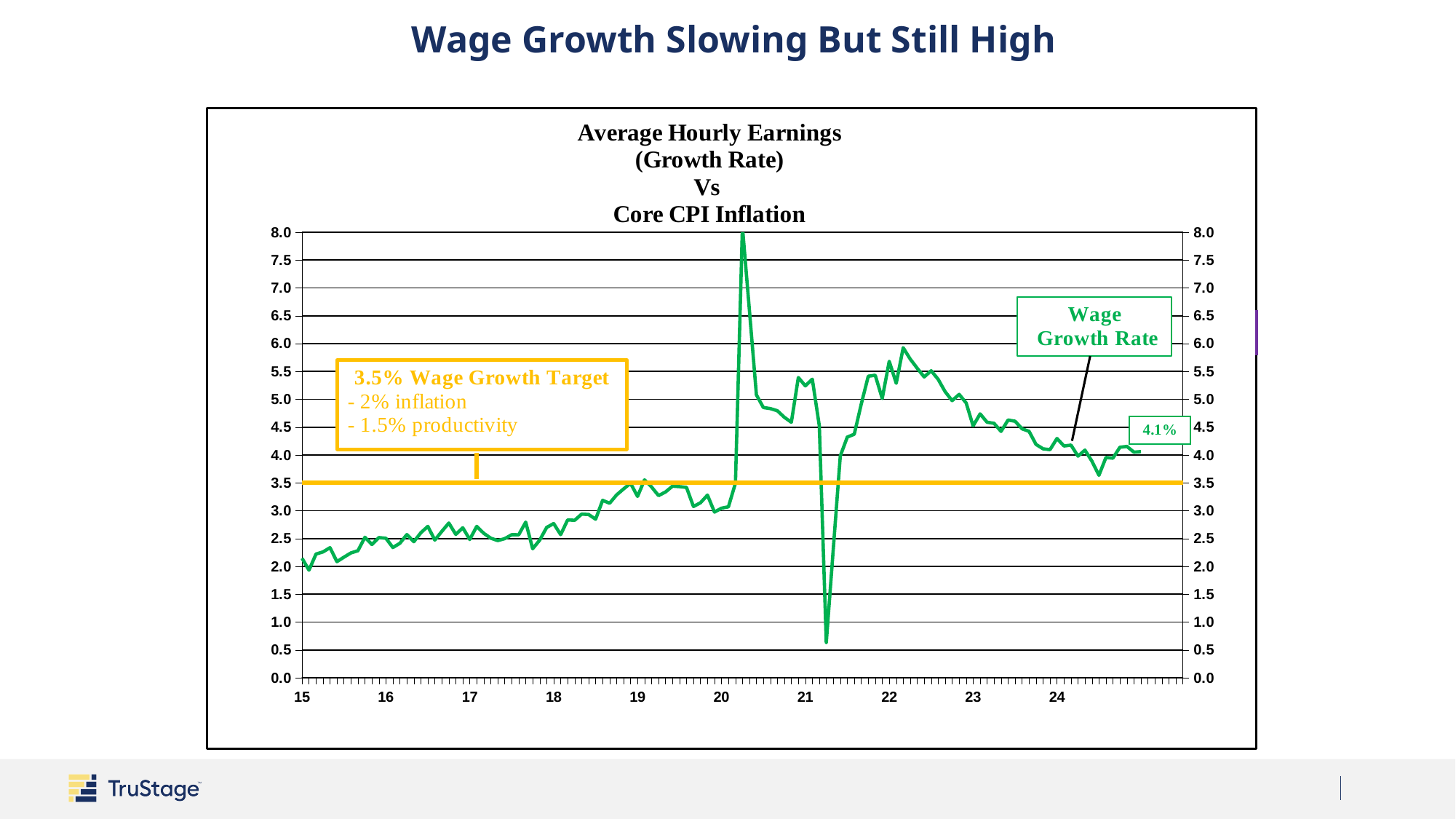
Is the latest Wage Growth Rate of 4.1% above or below the 3.5% Wage Growth Target? Above What is the title of the chart? Average Hourly Earnings (Growth Rate) Vs Core CPI Inflation Is the lowest point of the Wage Growth Rate in 2021 greater or less than 1.0? less Does the Wage Growth Rate generally rise or fall from 2022 to 2024? Fall According to the annotation, what two components make up the 3.5% Wage Growth Target? 2% inflation and 1.5% productivity What kind of chart is shown on the slide? Line chart What wage growth target is marked by the yellow horizontal line? 3.5% Does the Wage Growth Rate generally rise or fall from 2015 to 2019? Rise What is the latest value of the Wage Growth Rate labelled on the chart? 4.1% Is the peak of the Wage Growth Rate in 2020 greater or less than 7.0? greater Is the Wage Growth Rate at the start of 2015 greater or less than 2.5? less By how much does the latest Wage Growth Rate (4.1%) exceed the 3.5% Wage Growth Target? 0.6 percentage points